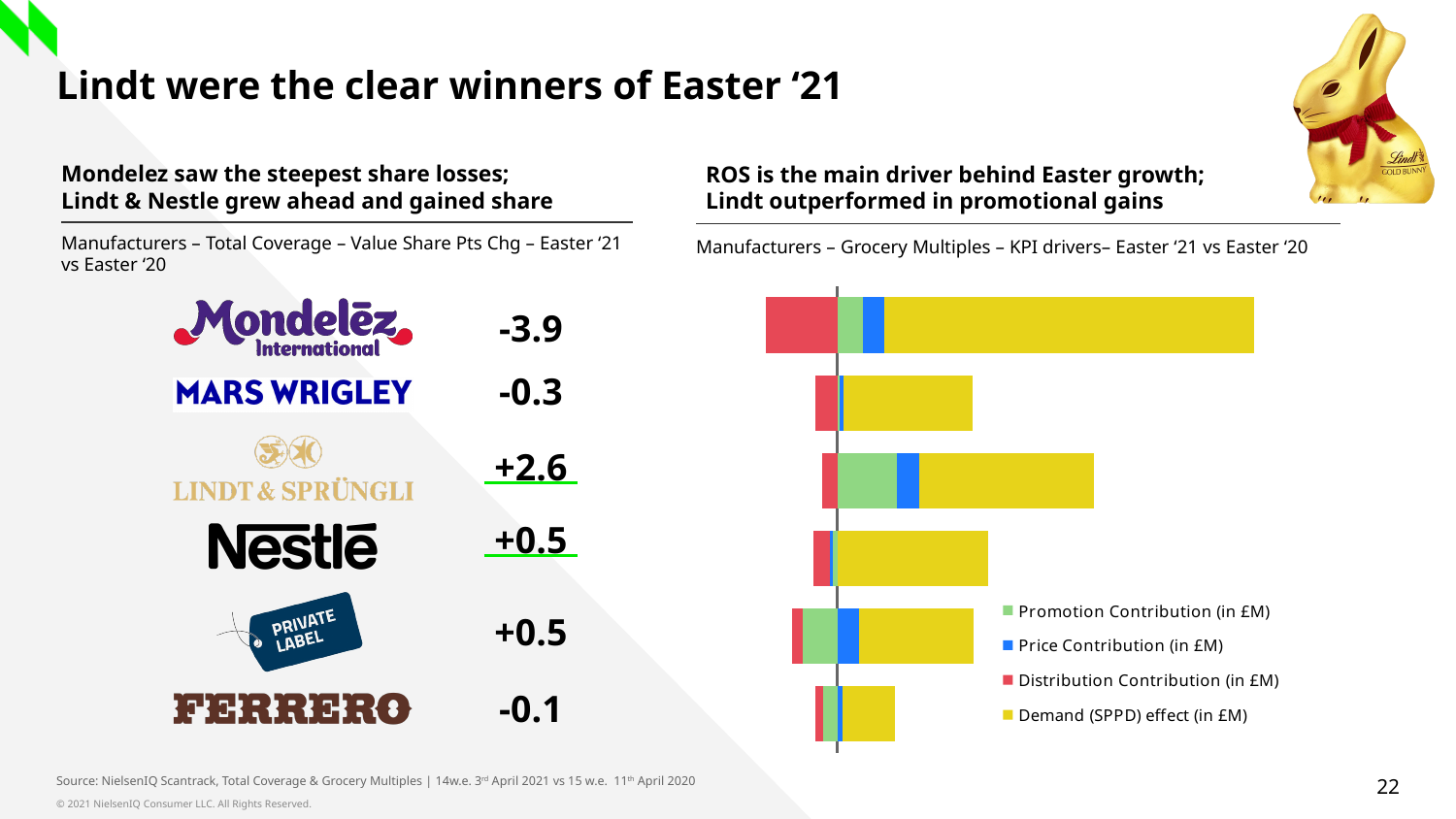
On the left chart (Value Share Pts Chg), what is the value shown for Ferrero? -0.1 On the left chart (Value Share Pts Chg), which manufacturer has the highest value? Lindt & Sprüngli On the right chart (KPI drivers – Easter '21 vs Easter '20), how many series does the legend list? 4 On the left chart (Value Share Pts Chg – Easter '21 vs Easter '20), what is the value shown for Mondelez International? -3.9 On the left chart (Value Share Pts Chg), what is the value shown for Lindt & Sprüngli? +2.6 On the left chart (Value Share Pts Chg), what is the difference between the values for Lindt & Sprüngli and Nestlé? 2.1 What kind of chart is the right chart (KPI drivers – Easter '21 vs Easter '20)? Stacked bar chart On the left chart (Value Share Pts Chg), how many manufacturers are listed? 6 On the left chart (Value Share Pts Chg), what is the value shown for Mars Wrigley? -0.3 On the right chart (KPI drivers), which colour represents Demand (SPPD) effect (in £M)? Yellow On the left chart (Value Share Pts Chg), which has the larger value, Mondelez International or Mars Wrigley? Mars Wrigley On the left chart (Value Share Pts Chg), which manufacturer has the lowest value? Mondelez International